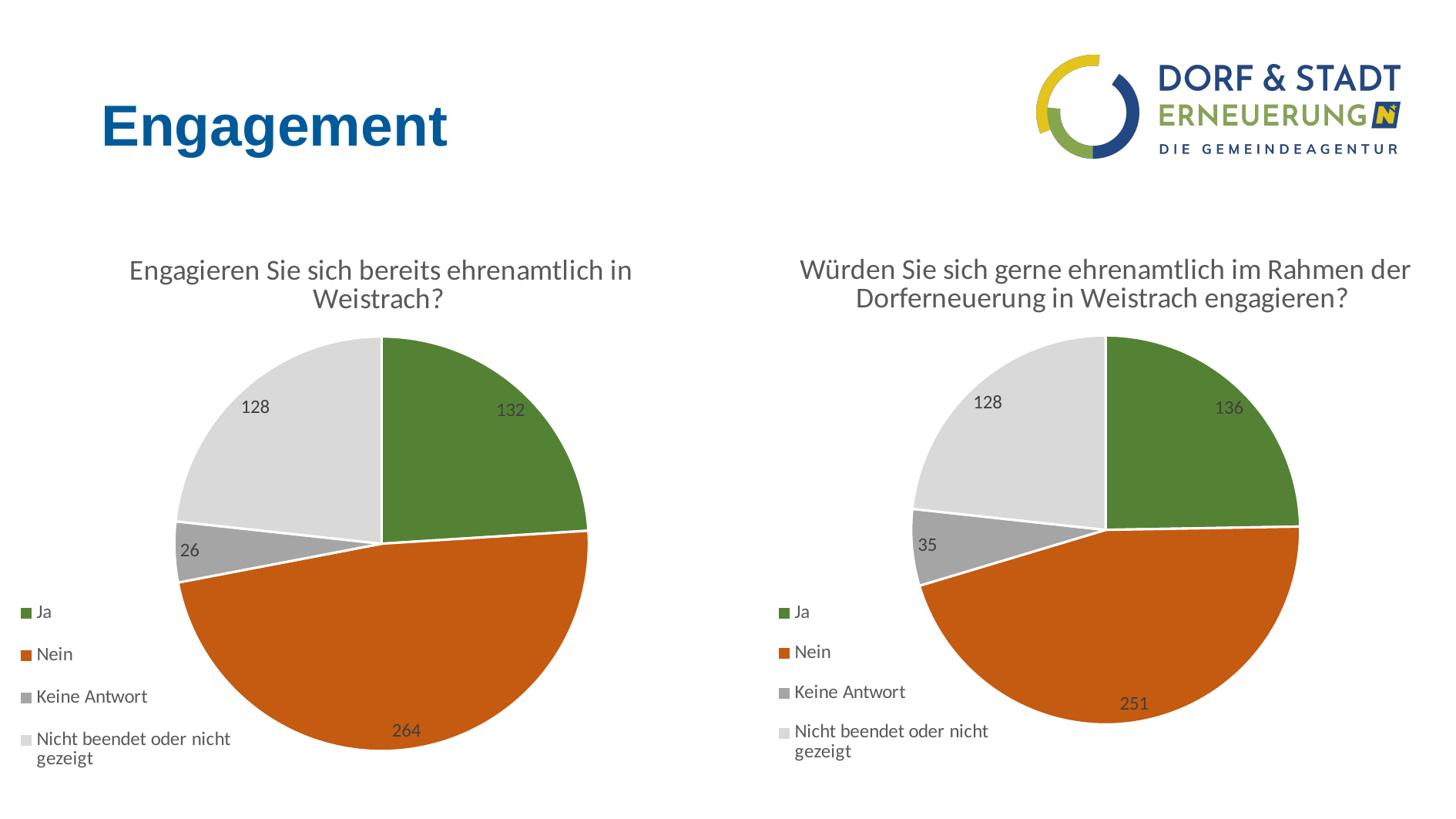
In the left chart, what is the difference between the values for "Nein" and "Ja"? 132 In the right chart ("Würden Sie sich gerne ehrenamtlich im Rahmen der Dorferneuerung in Weistrach engagieren?"), what is the value for "Ja"? 136 How many categories does the left chart show? 4 In the left chart ("Engagieren Sie sich bereits ehrenamtlich in Weistrach?"), what is the value for "Nein"? 264 In the left chart, what is the total of all slices? 550 In the right chart, which category has the largest slice? Nein In the left chart, what share of the total does the "Ja" slice represent? 24% What kind of chart is the right chart? Pie chart In the left chart, which category has the smallest slice? Keine Antwort In the right chart, what is the difference between the values for "Nicht beendet oder nicht gezeigt" and "Keine Antwort"? 93 Which is larger: the "Nein" value in the left chart or the "Nein" value in the right chart? Left chart (264) In the left chart, what is the value for "Keine Antwort"? 26